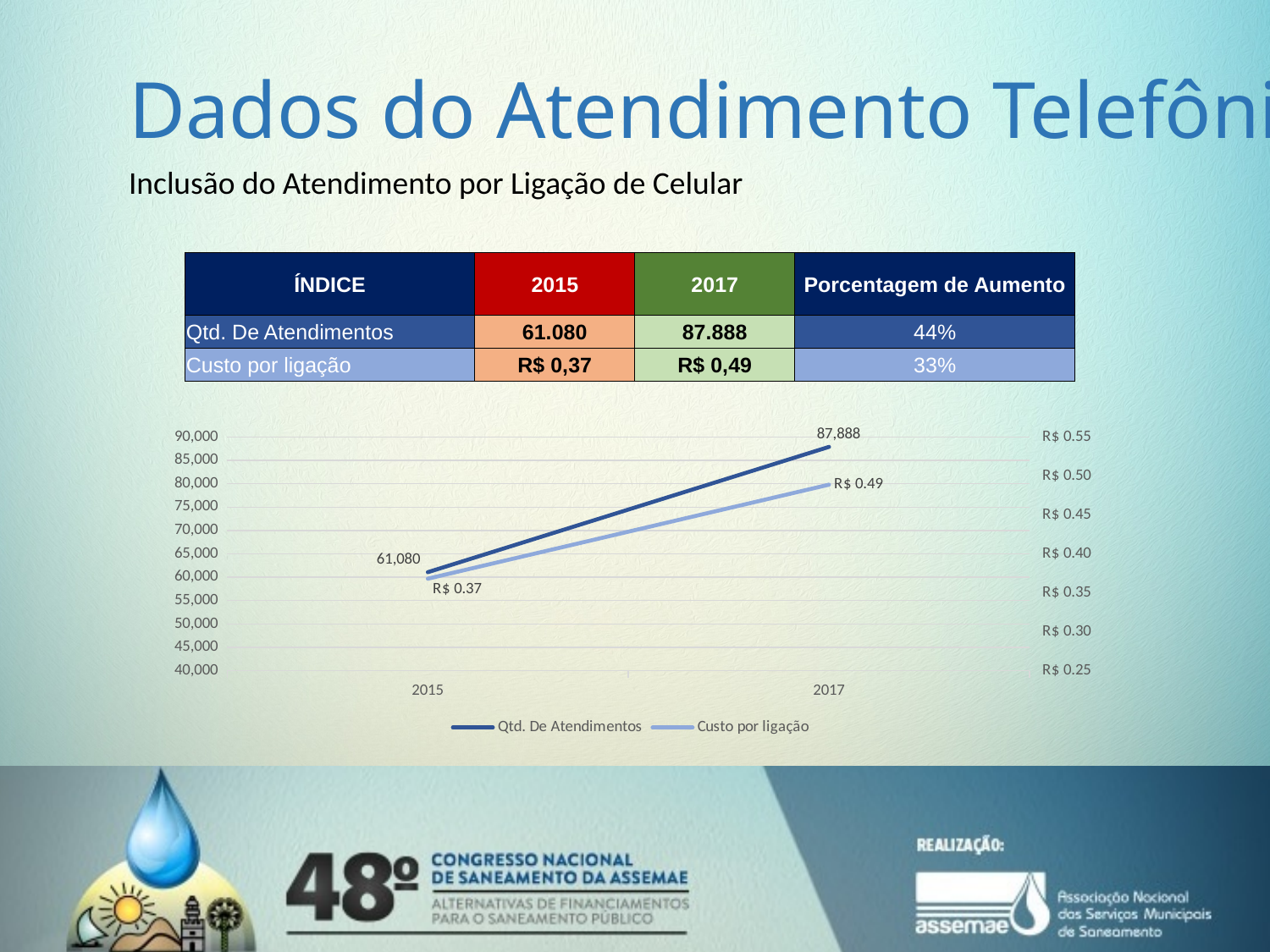
By how much did Qtd. De Atendimentos increase from 2015 to 2017 in the chart? 26,808 What are the two series named in the chart's legend? Qtd. De Atendimentos and Custo por ligação Which year has the higher Custo por ligação in the chart, 2015 or 2017? 2017 What is the Custo por ligação for 2015 according to the chart's data label? R$ 0.37 What kind of chart is shown on the slide? line chart What is the value of Qtd. De Atendimentos for 2017 in the chart? 87,888 Does the Qtd. De Atendimentos line rise or fall from 2015 to 2017? rise What is the Custo por ligação for 2017 according to the chart's data label? R$ 0.49 What is the difference in Custo por ligação between 2017 and 2015 in the chart? R$ 0.12 How many series does the chart's legend list? 2 How many years are shown on the x axis of the chart? 2 What is the value of Qtd. De Atendimentos for 2015 in the chart? 61,080